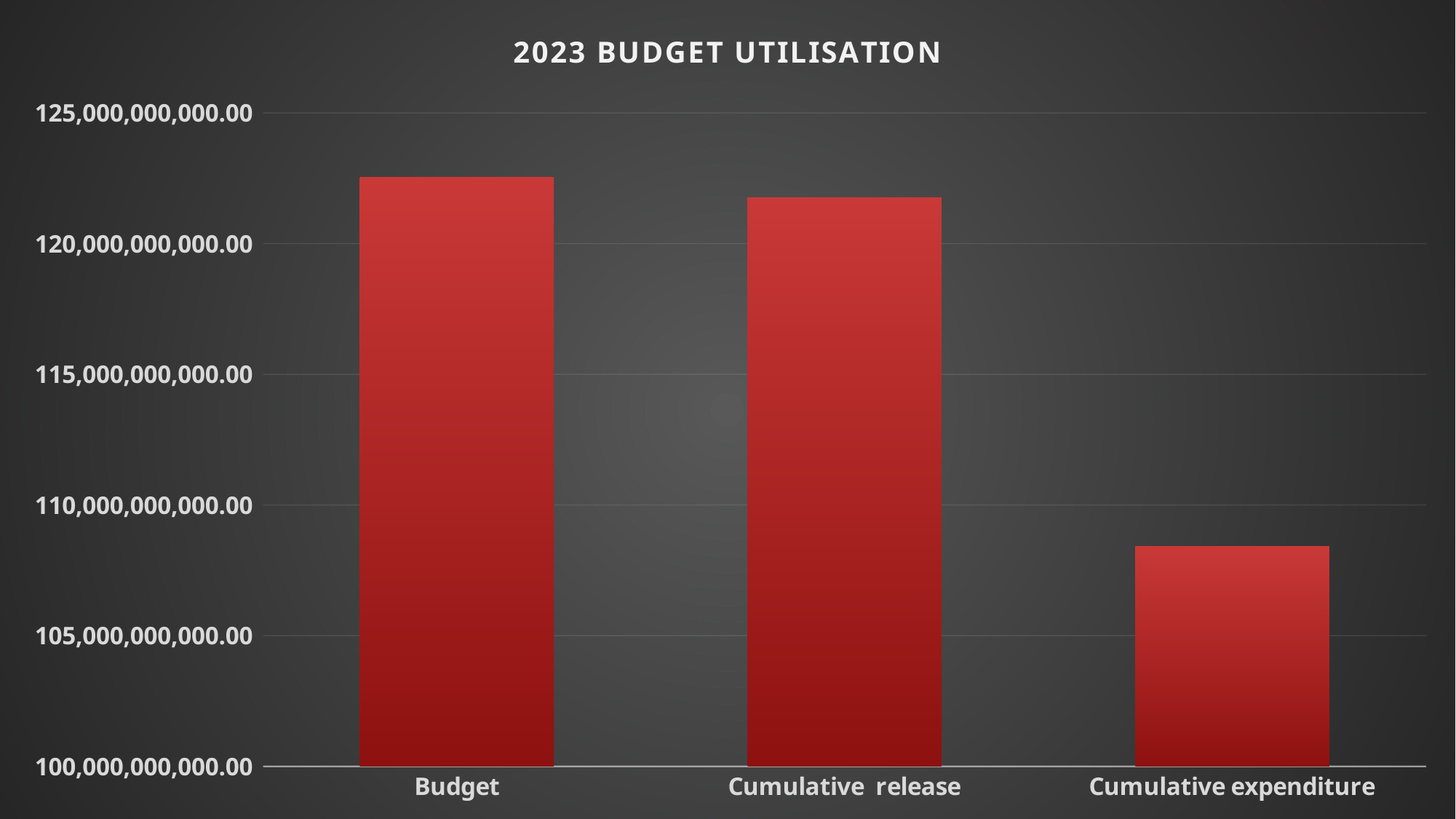
What is the title of the chart? 2023 BUDGET UTILISATION Which category has the highest value? Budget Is the value for Cumulative release greater or less than 120,000,000,000.00? greater Do the values rise or fall moving from left to right across the categories? fall Which category has the lowest value? Cumulative expenditure Which is larger, the value for Cumulative release or the value for Cumulative expenditure? Cumulative release What kind of chart is shown on the slide? bar chart Is the value for Cumulative expenditure greater or less than 105,000,000,000.00? greater Is the value for Cumulative expenditure greater or less than 110,000,000,000.00? less How many categories are plotted in the chart? 3 Which is larger, the value for Budget or the value for Cumulative expenditure? Budget